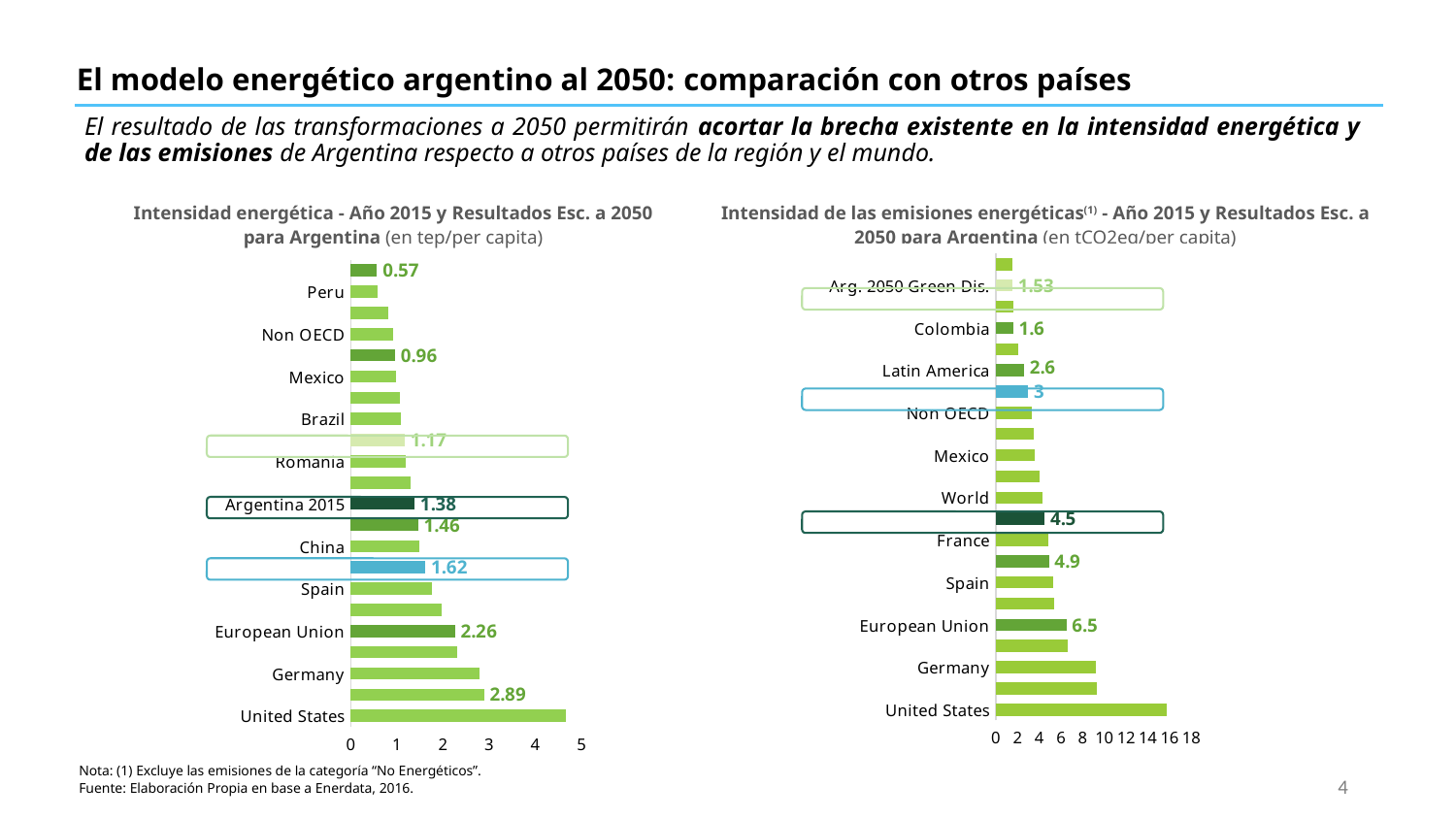
In the left chart 'Intensidad energética', what is the difference between the European Union value and the Argentina 2015 value? 0.88 In the right chart 'Intensidad de las emisiones energéticas', what is the value for Colombia? 1.6 In the right chart 'Intensidad de las emisiones energéticas', which is larger, the value for Latin America or the value for Colombia? Latin America What kind of chart is the left chart, 'Intensidad energética'? bar chart In the right chart 'Intensidad de las emisiones energéticas', what is the value for European Union? 6.5 In the left chart 'Intensidad energética', what is the value for Argentina 2015? 1.38 In the left chart 'Intensidad energética', is the value for United States greater or less than 4? greater In the right chart 'Intensidad de las emisiones energéticas', is the value for United States greater or less than 14? greater In the right chart 'Intensidad de las emisiones energéticas', what is the value for Latin America? 2.6 In the left chart 'Intensidad energética', which country has the longest bar? United States In the left chart 'Intensidad energética', what is the value for European Union? 2.26 In the left chart 'Intensidad energética', is the value for Peru greater or less than 1? less